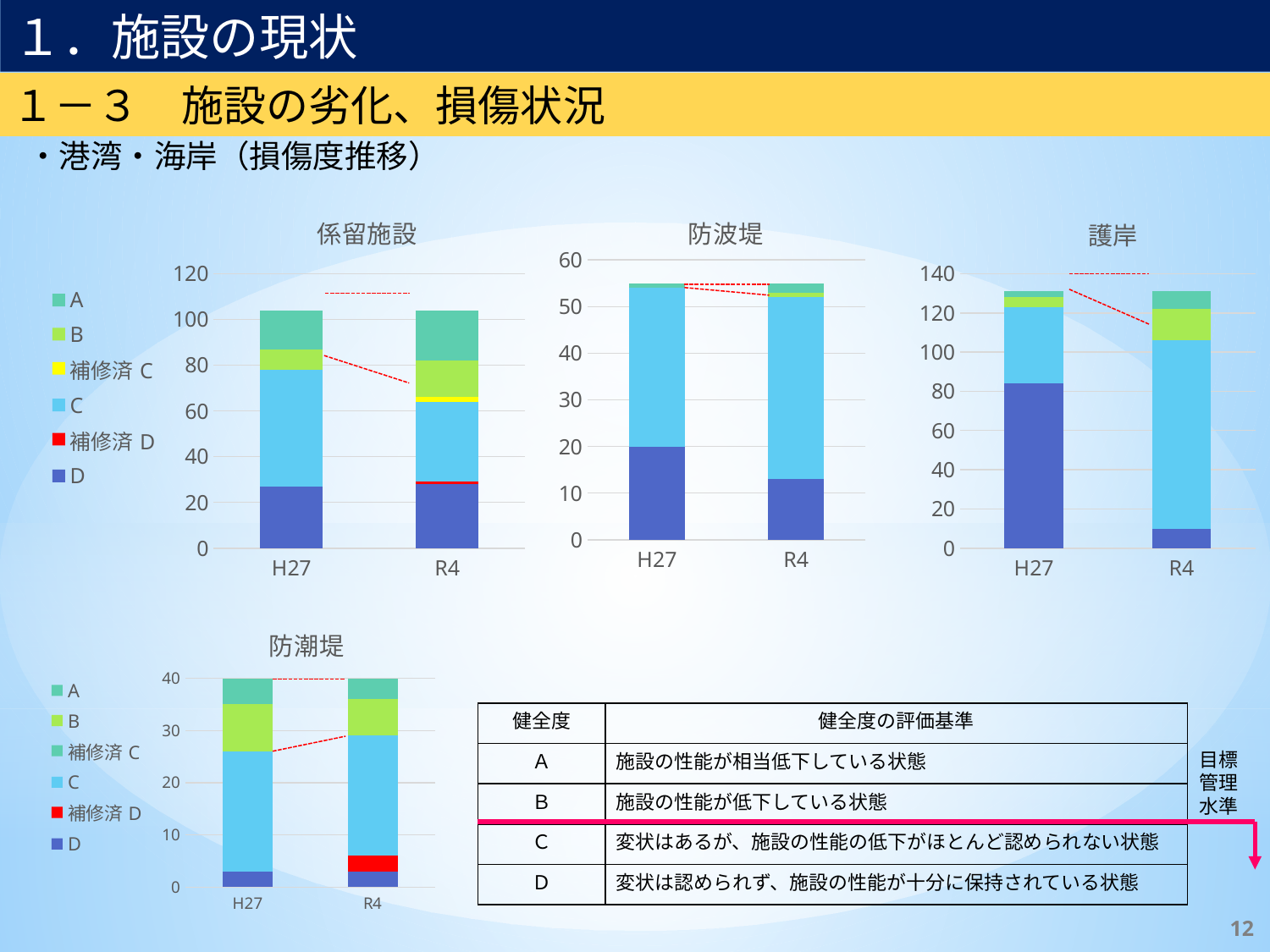
In the 護岸 chart, is the value of the D segment for H27 greater or less than 60? greater In the 防波堤 chart, is the value of the D segment for R4 greater or less than 20? less How many series does the legend of the 係留施設 chart list? 6 In the 護岸 chart, does the D segment rise or fall from H27 to R4? fall In the 係留施設 chart, is the value of the D segment for H27 greater or less than 40? less What kind of chart is the 係留施設 chart? stacked bar chart In the 防波堤 chart, which category has the larger D segment, H27 or R4? H27 How many categories are shown on the x axis of the 防波堤 chart? 2 What is the title of the chart at the bottom left of the slide? 防潮堤